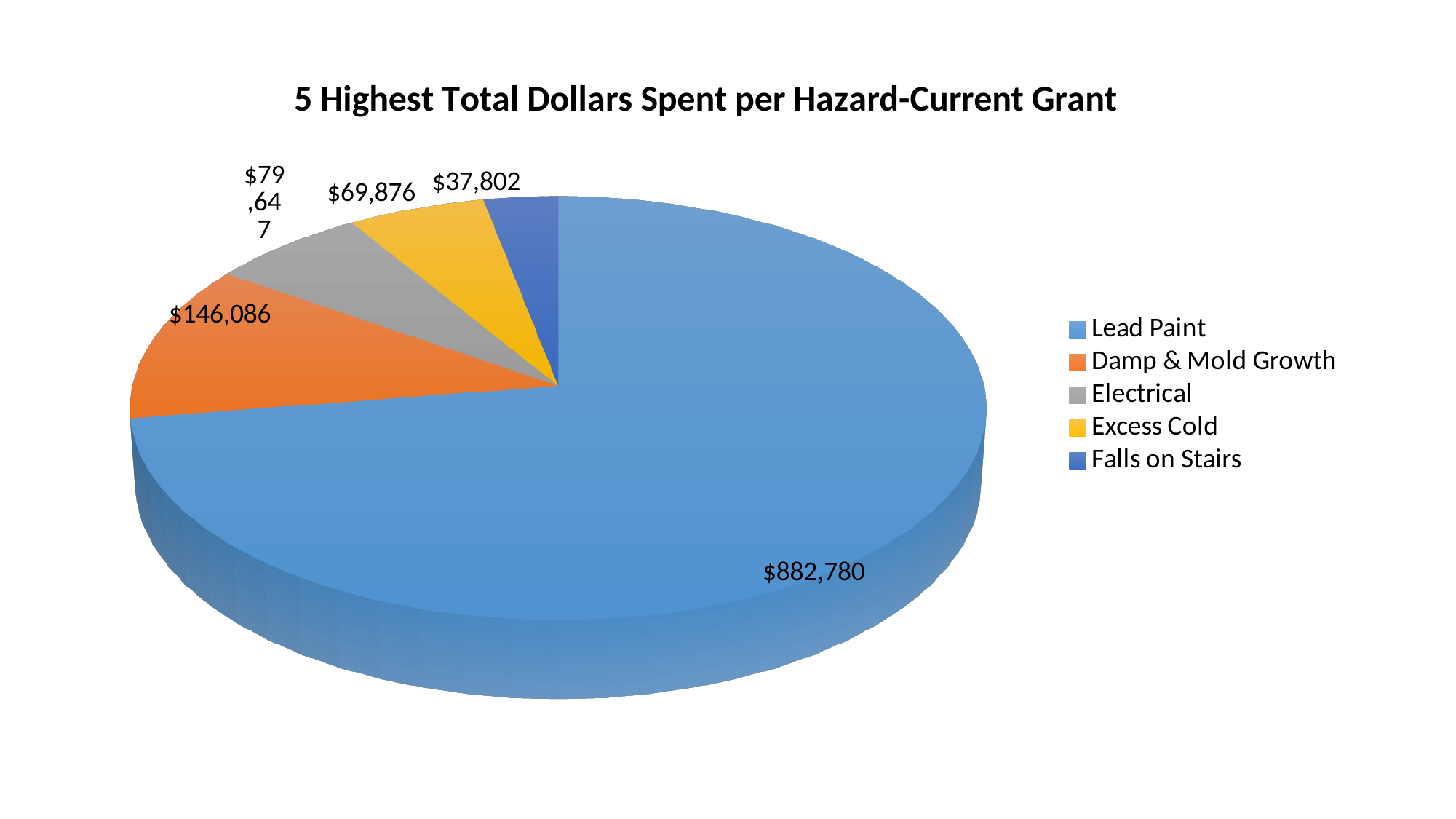
How much more was spent on Lead Paint than on Damp & Mold Growth? $736,694 Which hazard has the highest total dollars spent? Lead Paint What is the total dollars spent on Lead Paint? $882,780 How many hazard categories does the pie chart show? 5 What is the total dollars spent on Damp & Mold Growth? $146,086 What is the difference in dollars spent between Excess Cold and Falls on Stairs? $32,074 What is the title of the chart? 5 Highest Total Dollars Spent per Hazard-Current Grant Which hazard has the lowest total dollars spent? Falls on Stairs What type of chart is shown on the slide? Pie chart What is the total dollars spent on Falls on Stairs? $37,802 Which has more dollars spent, Electrical or Excess Cold? Electrical What is the total dollars spent on Excess Cold? $69,876